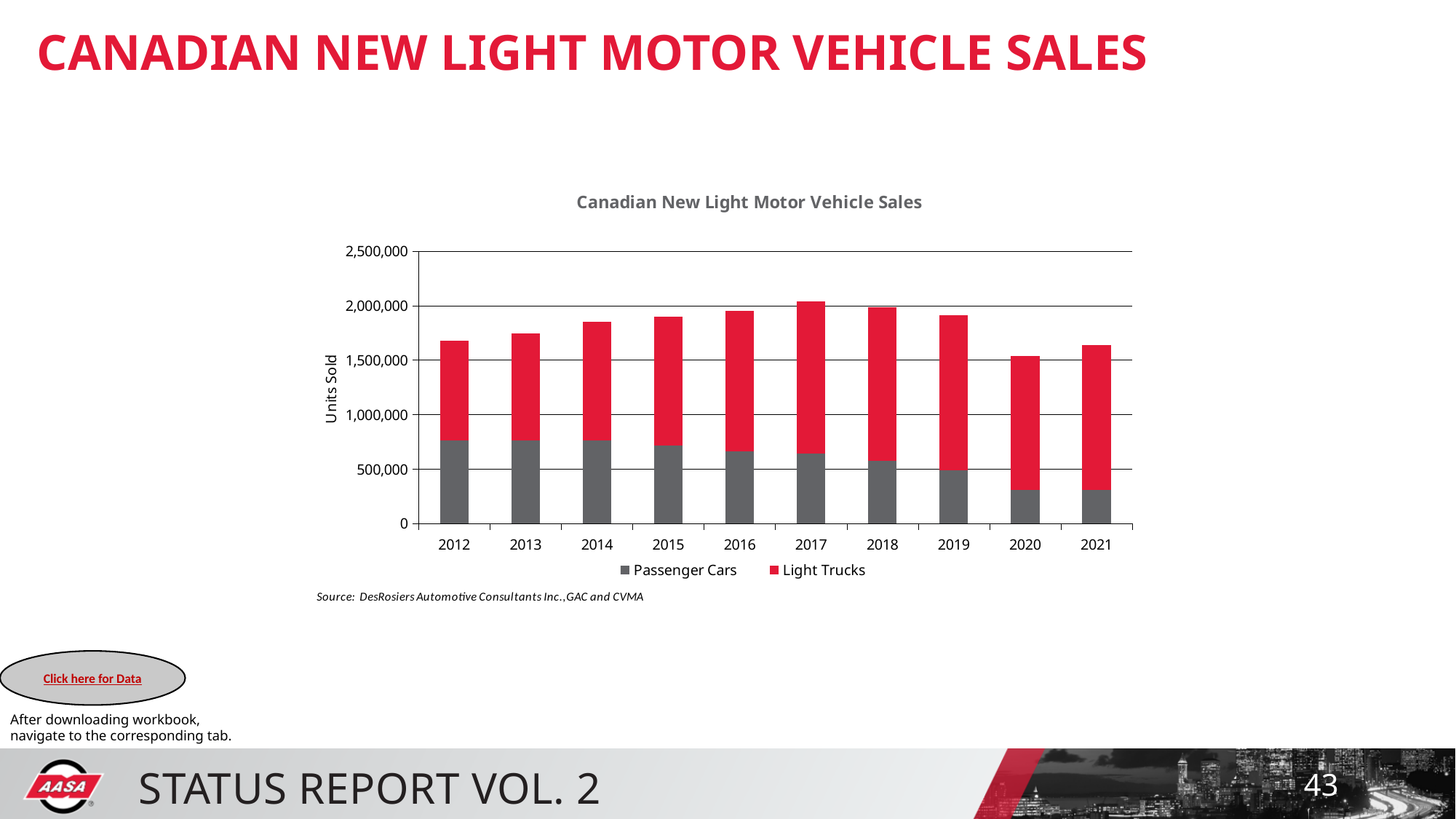
Is the Passenger Cars value for 2012 greater or less than 500,000? greater How many series does the chart's legend list? 2 Is the Passenger Cars value for 2020 greater or less than 500,000? less Is the total sales value for 2020 greater or less than 2,000,000? less Which year has the highest total new light motor vehicle sales? 2017 How many years are shown on the x axis of the chart? 10 What is the label on the chart's vertical axis? Units Sold What kind of chart is shown on the slide? Stacked bar chart Do Passenger Cars sales generally rise or fall from 2012 to 2021? fall Which year has the lowest total new light motor vehicle sales? 2020 Which year has the larger Passenger Cars value, 2012 or 2021? 2012